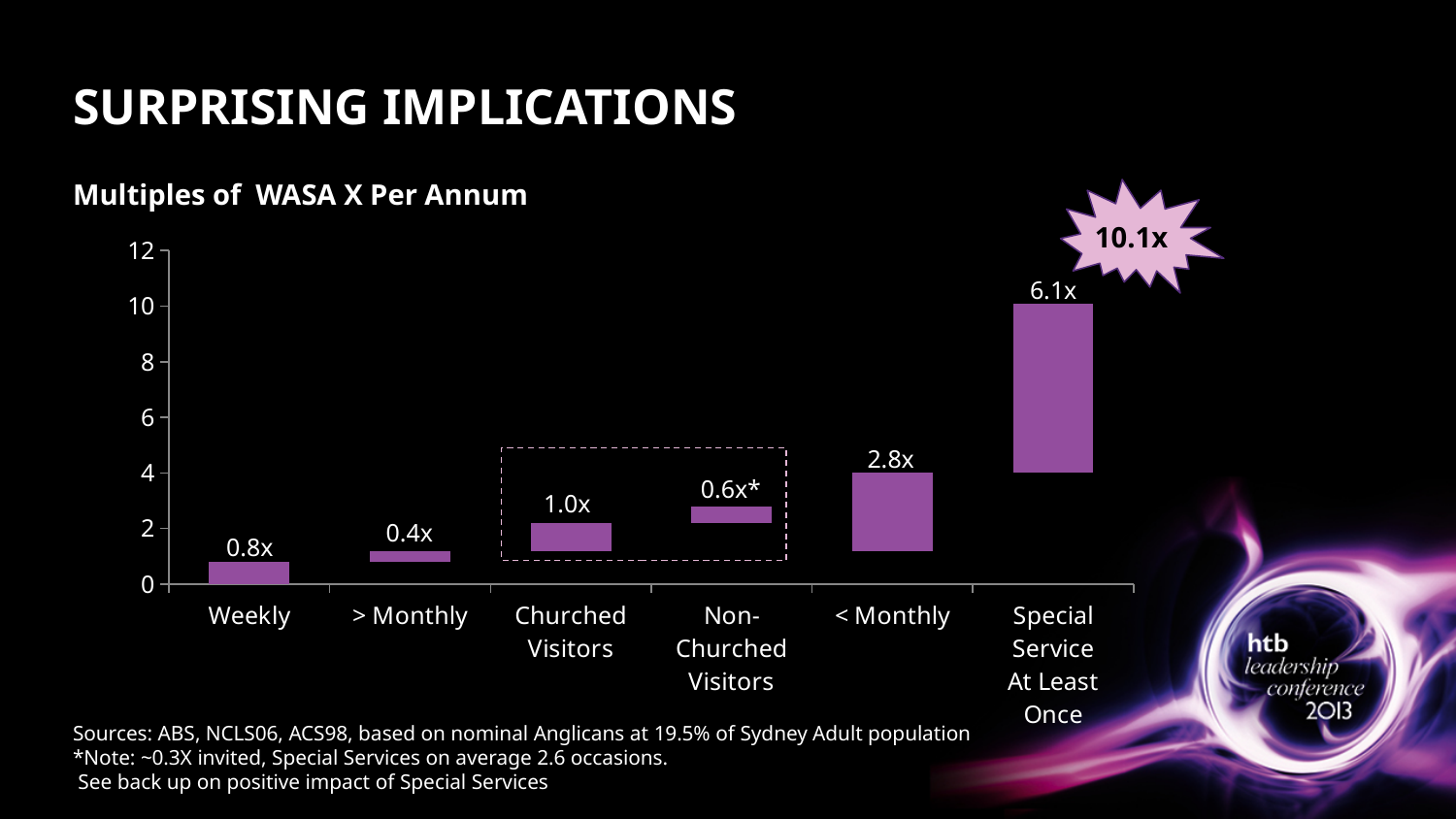
What is the value shown for > Monthly? 0.4x What is the value shown for < Monthly? 2.8x How many categories are shown on the x axis? 6 What is the difference between the values for Special Service At Least Once and < Monthly? 3.3x Which category has the highest value? Special Service At Least Once Which is larger, the value for Churched Visitors or the value for Non-Churched Visitors? Churched Visitors What is the value shown for Churched Visitors? 1.0x Which category has the lowest value? > Monthly What is the value shown for Special Service At Least Once? 6.1x What is the title of the chart? Multiples of WASA X Per Annum What is the value shown for Non-Churched Visitors? 0.6x* What is the value shown for Weekly? 0.8x